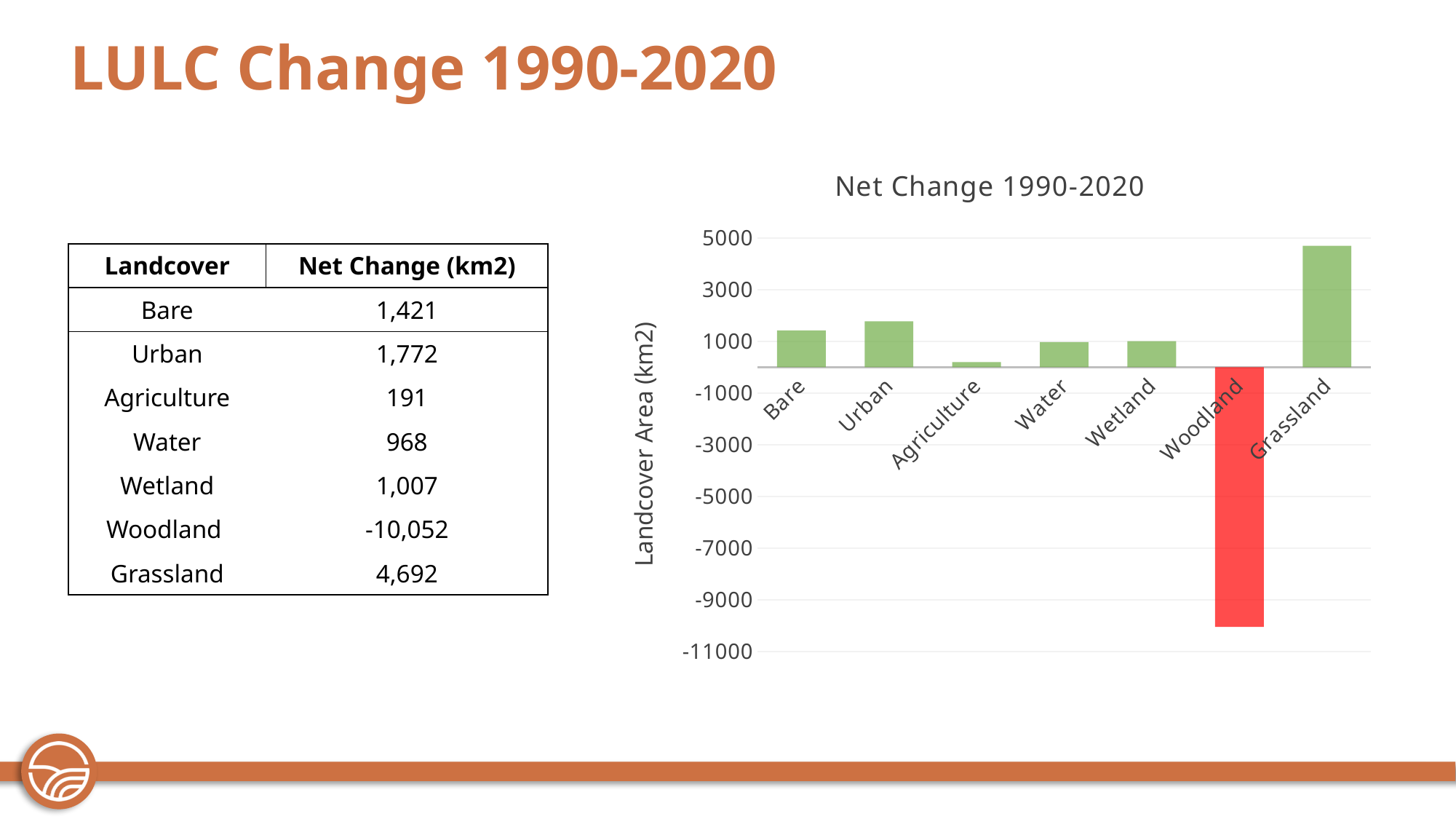
What is the difference in net change between Urban and Bare? 351 What is the net change (km2) for Grassland? 4,692 What type of chart is shown on the slide? Bar chart What is the net change (km2) for Agriculture? 191 What is the label of the vertical axis of the chart? Landcover Area (km2) What is the net change (km2) for Woodland? -10,052 Which landcover category has the lowest net change in the chart? Woodland Which landcover category has the highest net change in the chart? Grassland What is the title of the chart? Net Change 1990-2020 How many landcover categories are plotted in the chart? 7 Which has a larger net change, Bare or Water? Bare Is the net change for Urban greater or less than 1000? greater